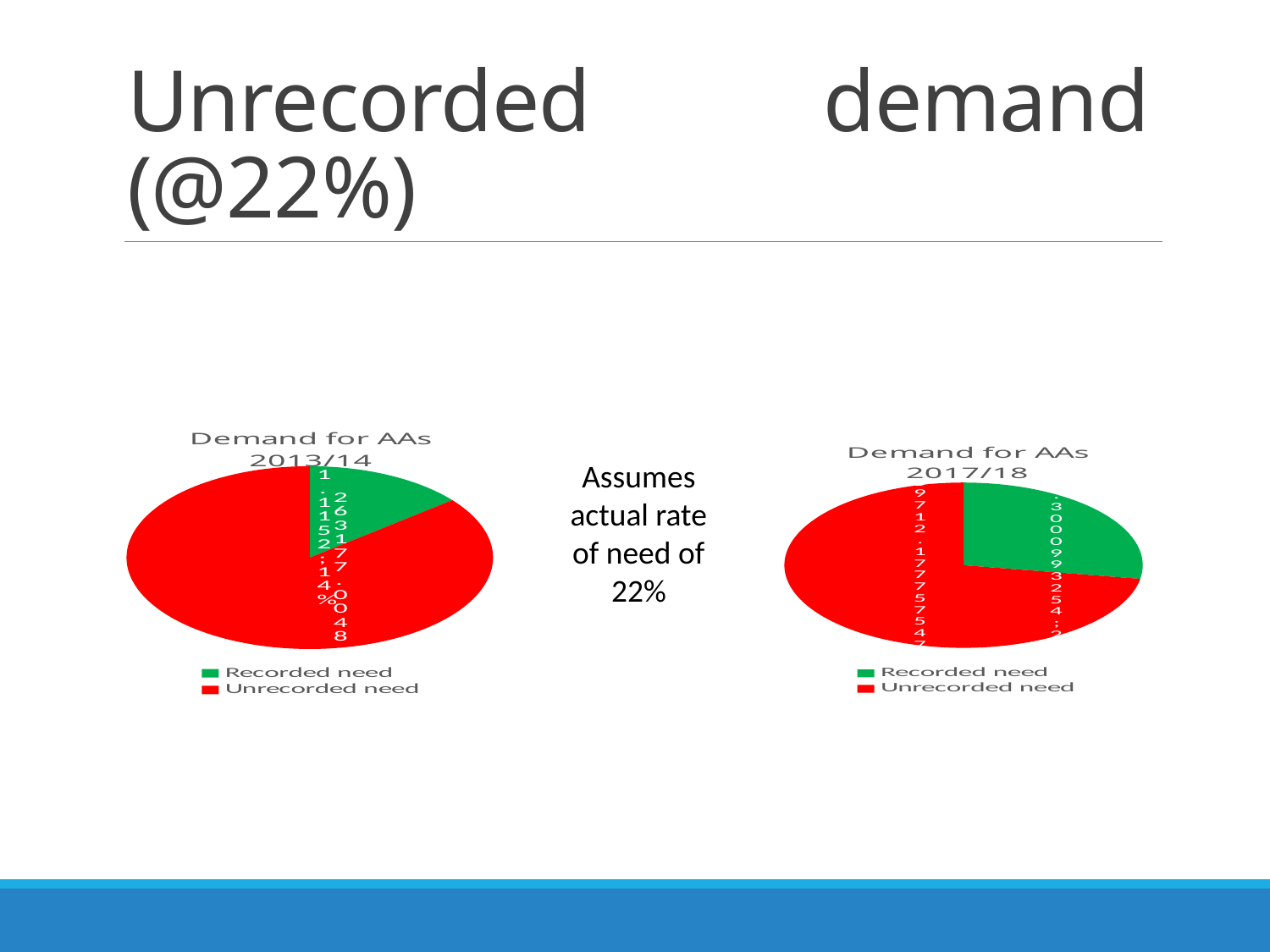
How many entries does the legend of the 'Demand for AAs 2013/14' chart list? 2 What is the title of the pie chart on the left of the slide? Demand for AAs 2013/14 How many slices does the 'Demand for AAs 2013/14' pie chart have? 2 How many entries does the legend of the 'Demand for AAs 2017/18' chart list? 2 In the 'Demand for AAs 2017/18' chart, which slice is the smallest? Recorded need How many slices does the 'Demand for AAs 2017/18' pie chart have? 2 What kind of chart is the 'Demand for AAs 2013/14' chart? Pie chart What colour represents 'Unrecorded need' in the 'Demand for AAs 2017/18' chart? Red In the 'Demand for AAs 2013/14' chart, which slice is the largest? Unrecorded need What kind of chart is the 'Demand for AAs 2017/18' chart? Pie chart In the 'Demand for AAs 2017/18' chart, which is larger: Recorded need or Unrecorded need? Unrecorded need In the 'Demand for AAs 2013/14' chart, which is smaller: Recorded need or Unrecorded need? Recorded need